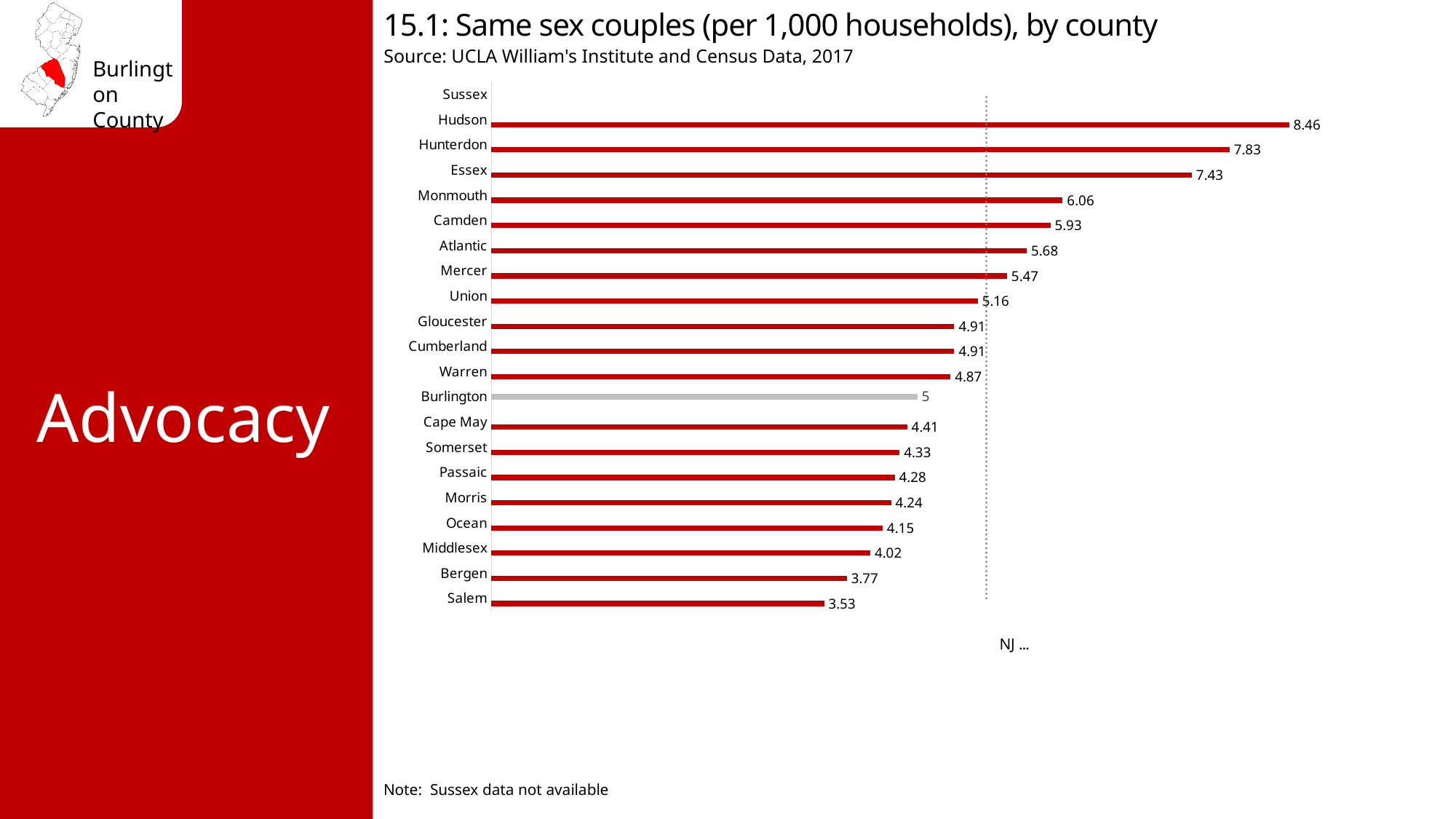
Which county has the highest value in the chart? Hudson How many counties are listed on the vertical axis of the chart? 21 According to the note on the slide, which county's data is not available? Sussex What is the value for Salem? 3.53 What is the value shown for Burlington? 5 What is the value for Camden? 5.93 What is the difference between the values for Hudson and Hunterdon? 0.63 What is the value for Hudson in the chart? 8.46 What kind of chart is shown on the slide? Bar chart Which has a larger value, Essex or Monmouth? Essex Which county with a plotted bar has the lowest value? Salem Which county's bar is drawn in gray rather than red? Burlington